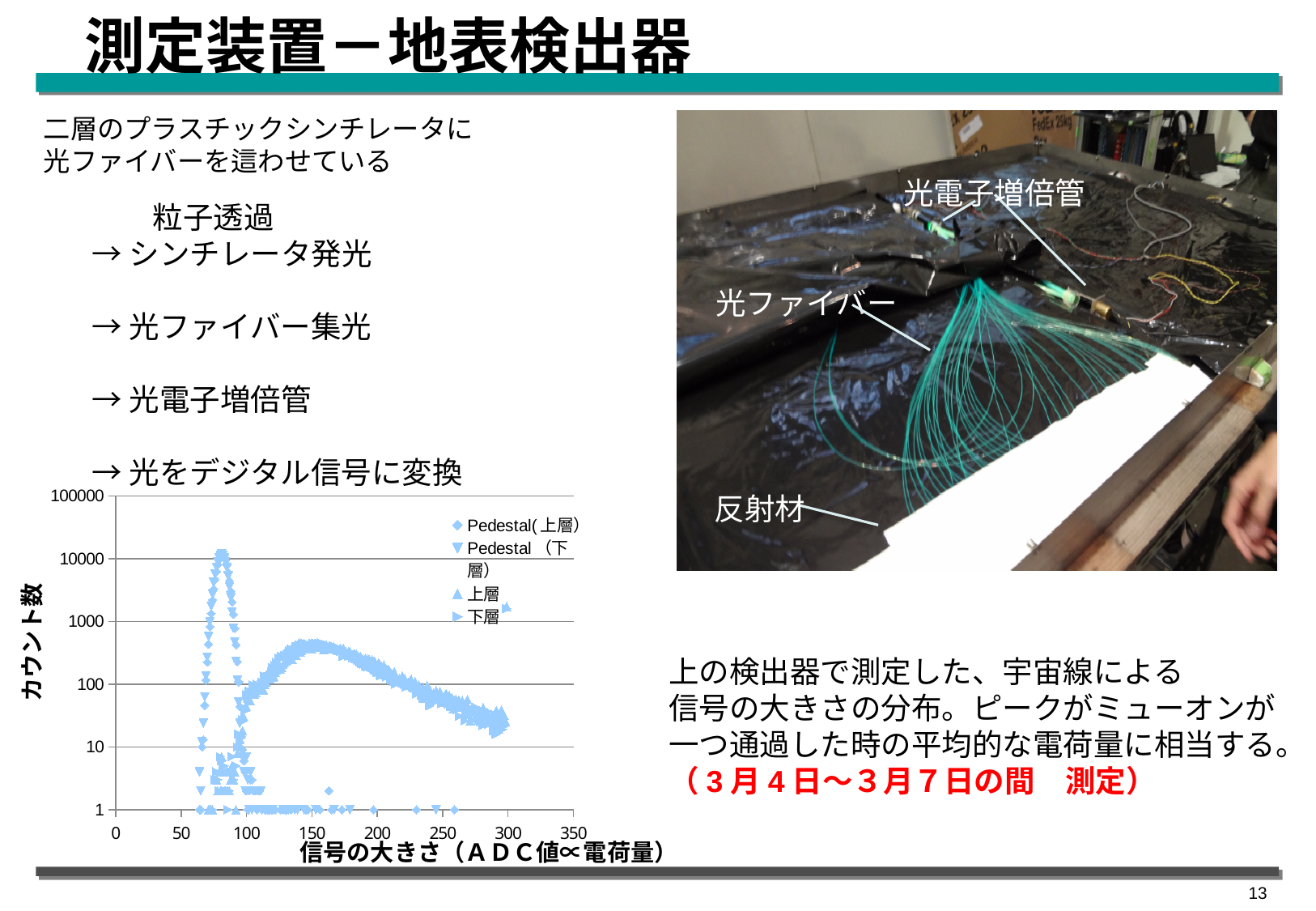
What is the title of the x axis of the chart? 信号の大きさ（ＡＤＣ値∝電荷量） What is the title of the y axis of the chart? カウント数 What is the highest tick value shown on the x axis of the chart? 350 Is the peak count of the narrow Pedestal distribution near an ADC value of 80 greater or less than 1000? greater How many series does the legend of the chart list? 4 What is the lowest tick value shown on the y axis of the chart? 1 What is the highest tick value shown on the y axis of the chart? 100000 Is the peak count of the broad distribution near an ADC value of 150 greater or less than 100? greater What kind of chart is shown at the bottom left of the slide? scatter chart Between ADC values of 150 and 300, do the counts of the broad distribution rise or fall? fall Which has a higher peak count: the narrow Pedestal peak near 80 or the broad peak near 150? the Pedestal peak near 80